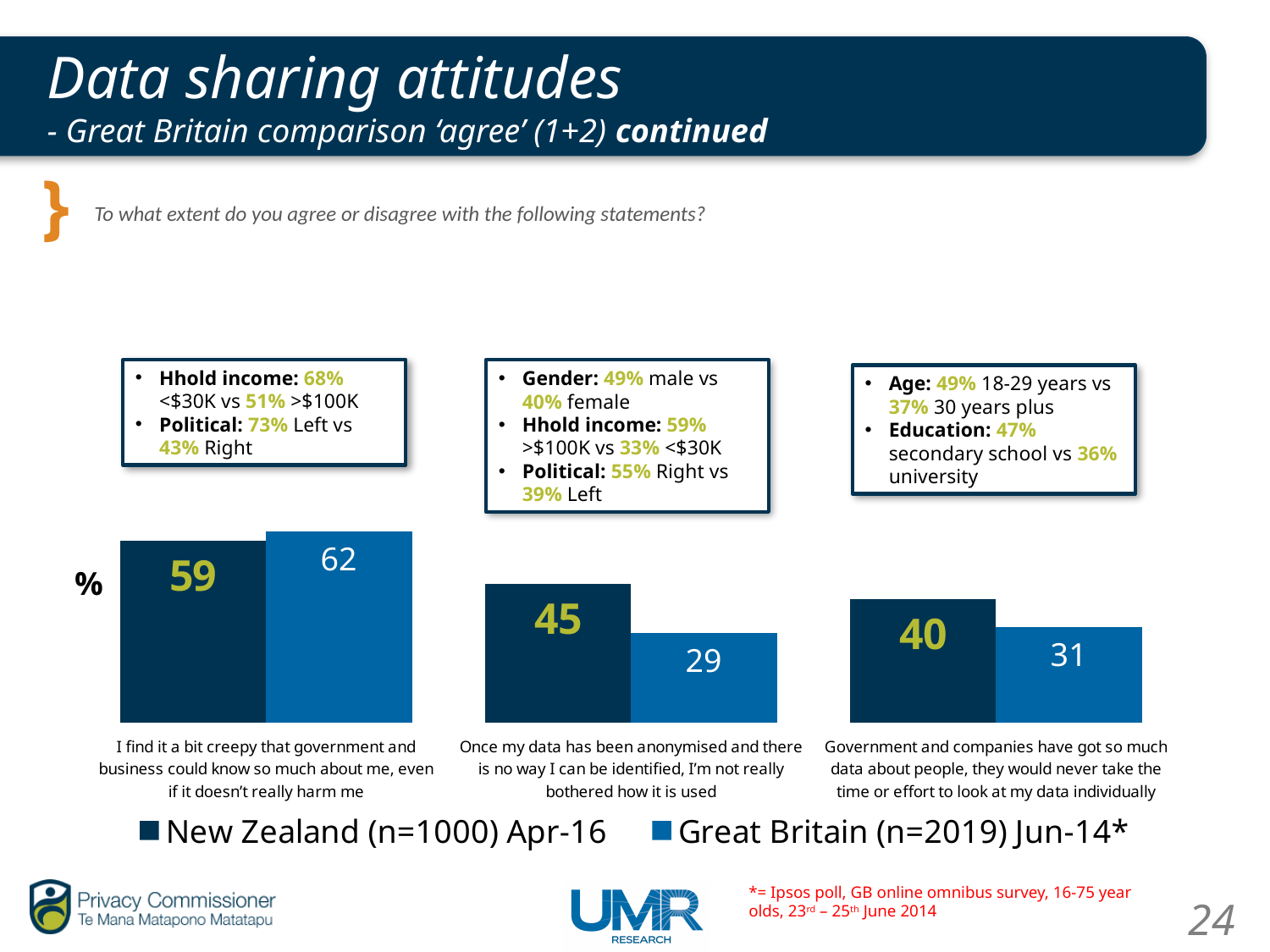
How many statements (categories) are shown in the chart? 3 Which statement has the lowest Great Britain value? Once my data has been anonymised and there is no way I can be identified, I'm not really bothered how it is used What is the difference between the New Zealand and Great Britain values for the statement "Once my data has been anonymised and there is no way I can be identified, I'm not really bothered how it is used"? 16 What is the Great Britain value for the statement "I find it a bit creepy that government and business could know so much about me, even if it doesn't really harm me"? 62 Which statement has the highest New Zealand value? I find it a bit creepy that government and business could know so much about me, even if it doesn't really harm me What kind of chart is shown on the slide? Bar chart What is the New Zealand value for the statement "Government and companies have got so much data about people, they would never take the time or effort to look at my data individually"? 40 What is the sample size for the New Zealand series shown in the legend? n=1000 How many series does the chart legend list? 2 What is the Great Britain value for the statement "Once my data has been anonymised and there is no way I can be identified, I'm not really bothered how it is used"? 29 What is the New Zealand value for the statement "I find it a bit creepy that government and business could know so much about me, even if it doesn't really harm me"? 59 For the statement "I find it a bit creepy that government and business could know so much about me, even if it doesn't really harm me", which is larger: the New Zealand value or the Great Britain value? Great Britain